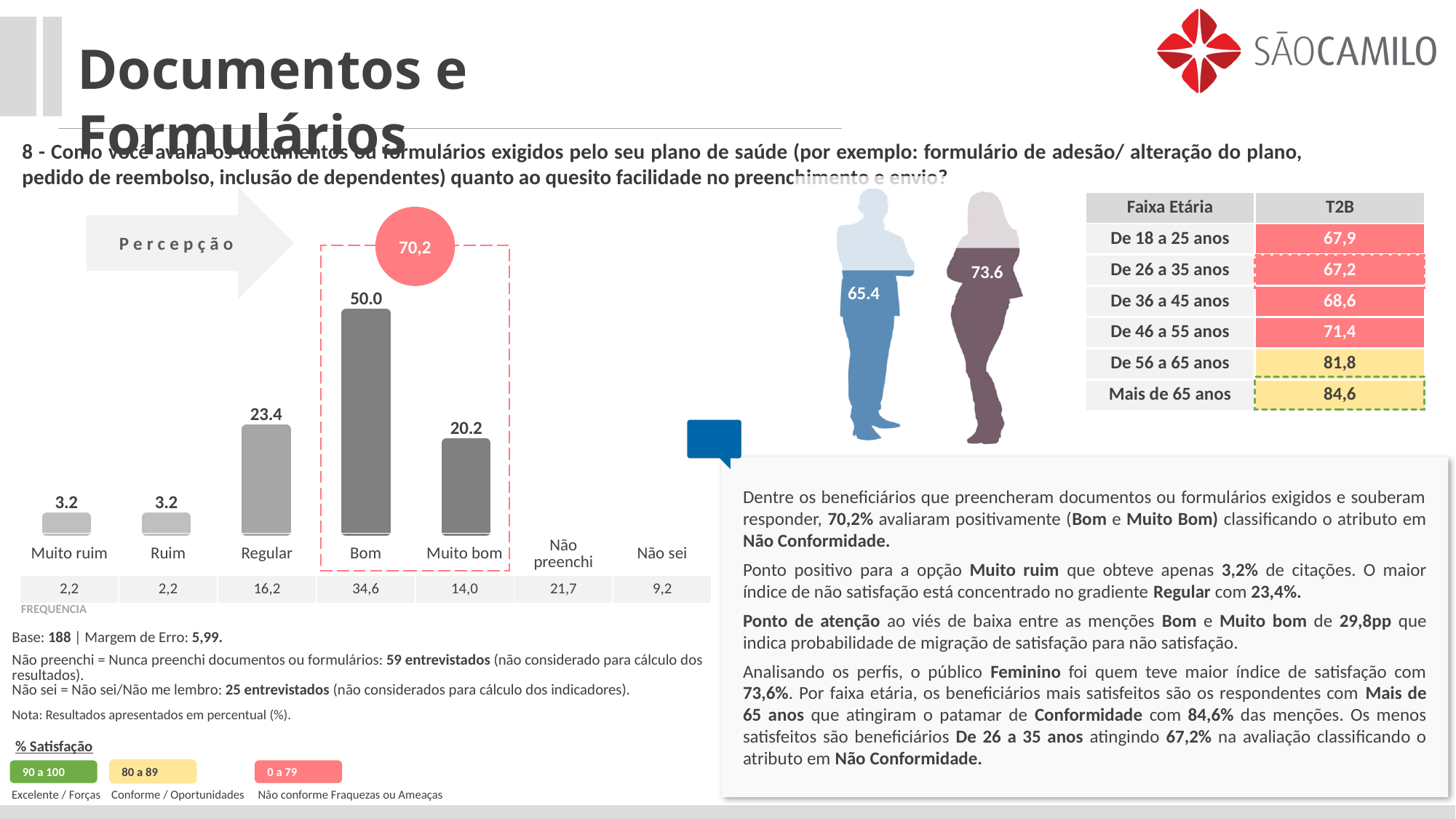
What kind of chart is used to show the Percepção results? bar chart What is the value for Regular in the bar chart? 23.4 What value is shown in the circle above the Bom and Muito bom bars? 70,2 Which is larger in the bar chart, the value for Regular or the value for Muito bom? Regular What is the value for Bom in the bar chart? 50.0 What is the difference between the values for Bom and Muito bom in the bar chart? 29.8 What is the value for Muito ruim in the bar chart? 3.2 Which category has the highest value in the bar chart? Bom What is the value for Muito bom in the bar chart? 20.2 What is the difference between the values for Regular and Muito bom in the bar chart? 3.2 Do the values for Muito ruim and Ruim in the bar chart differ? No, both are 3.2 What is the frequency value shown below the Bom bar in the FREQUENCIA row? 34,6